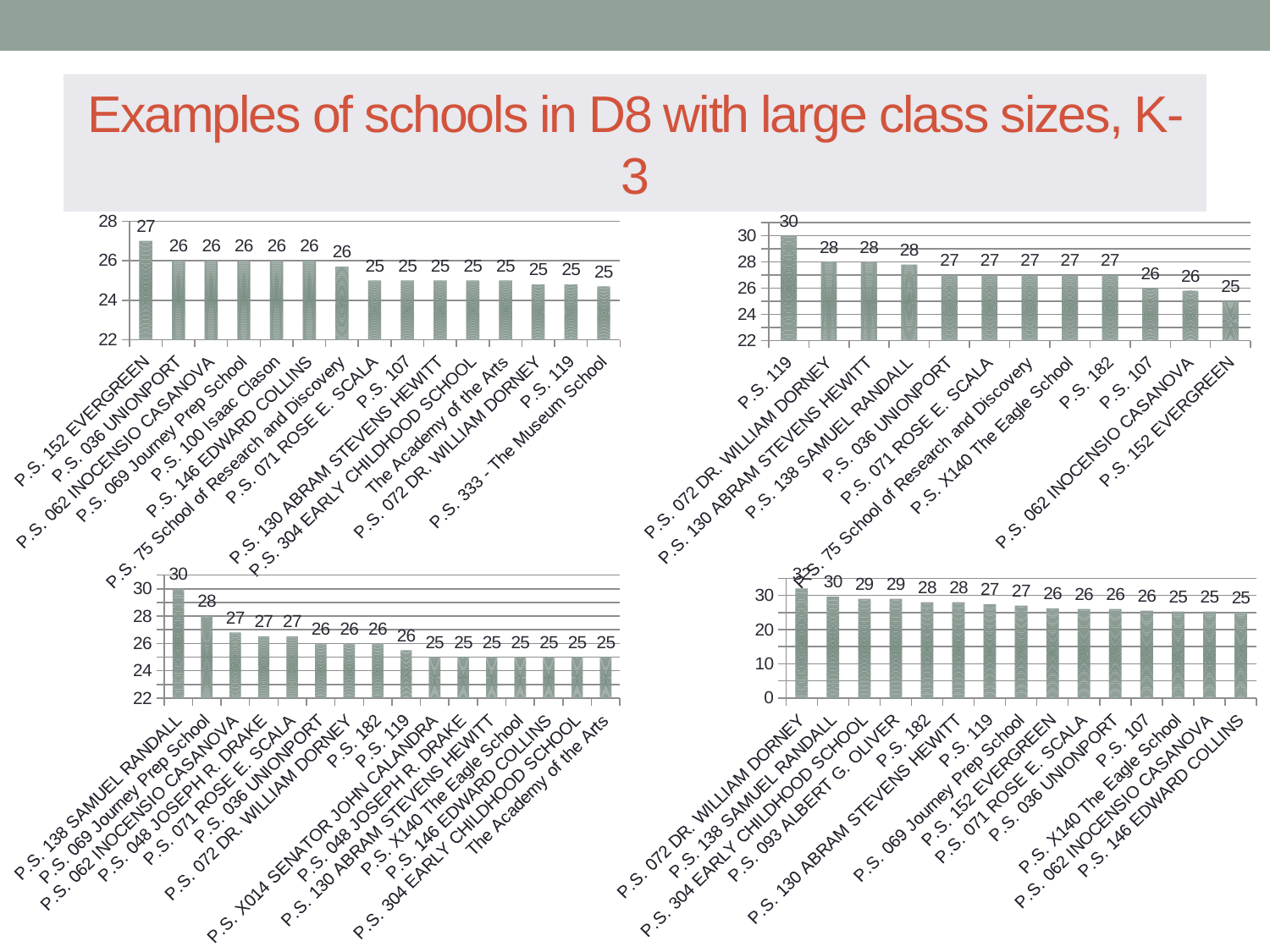
How many bars are in the top-right chart? 12 In the bottom-left chart, what is the value for P.S. 069 Journey Prep School? 28 In the bottom-left chart, which school has the highest value? P.S. 138 SAMUEL RANDALL In the bottom-right chart, what is the difference between P.S. 072 DR. WILLIAM DORNEY and P.S. 146 EDWARD COLLINS? 7 In the bottom-right chart, what is the value for P.S. 072 DR. WILLIAM DORNEY? 32 In the top-left chart, what is the value for P.S. 152 EVERGREEN? 27 What is the title of the slide? Examples of schools in D8 with large class sizes, K-3 In the top-right chart, what is the value for P.S. 152 EVERGREEN? 25 In the bottom-right chart, do the values generally rise or fall from left to right? Fall In the top-right chart, which school has the highest value? P.S. 119 In the top-right chart, which is larger, the value for P.S. 119 or the value for P.S. 107? P.S. 119 What kind of chart is the bottom-right chart? Bar chart